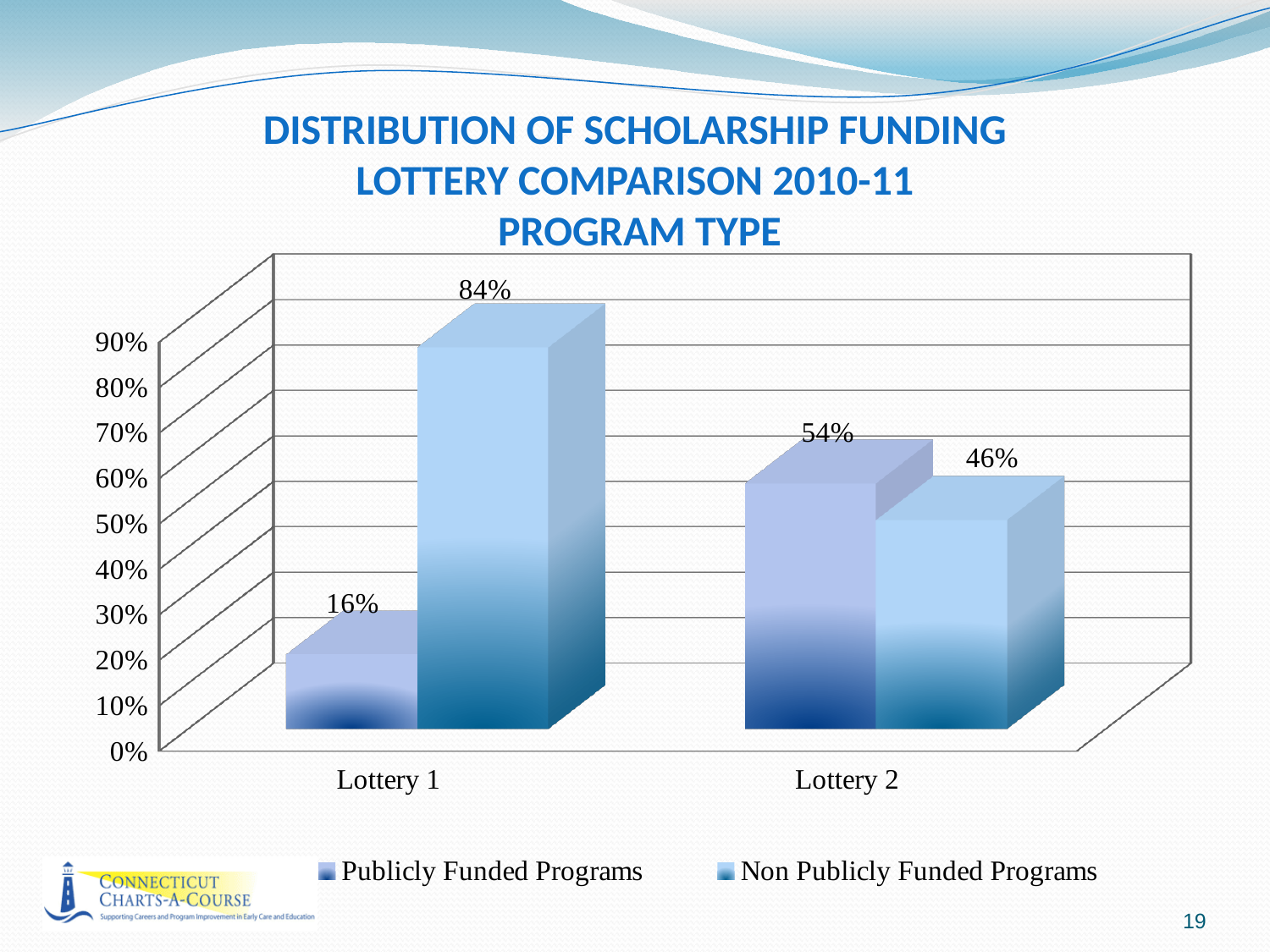
How many categories are shown on the x axis? 2 What is the difference between Non Publicly Funded Programs and Publicly Funded Programs in Lottery 1? 68% What is the value for Publicly Funded Programs in Lottery 1? 16% What is the value for Publicly Funded Programs in Lottery 2? 54% Which bar has the lowest value on the chart? Publicly Funded Programs, Lottery 1 What kind of chart is shown on the slide? Bar chart How many series does the legend list? 2 In Lottery 2, which is larger: Publicly Funded Programs or Non Publicly Funded Programs? Publicly Funded Programs What is the difference between Publicly Funded Programs and Non Publicly Funded Programs in Lottery 2? 8% What is the value for Non Publicly Funded Programs in Lottery 2? 46% Which bar has the highest value on the chart? Non Publicly Funded Programs, Lottery 1 What is the value for Non Publicly Funded Programs in Lottery 1? 84%